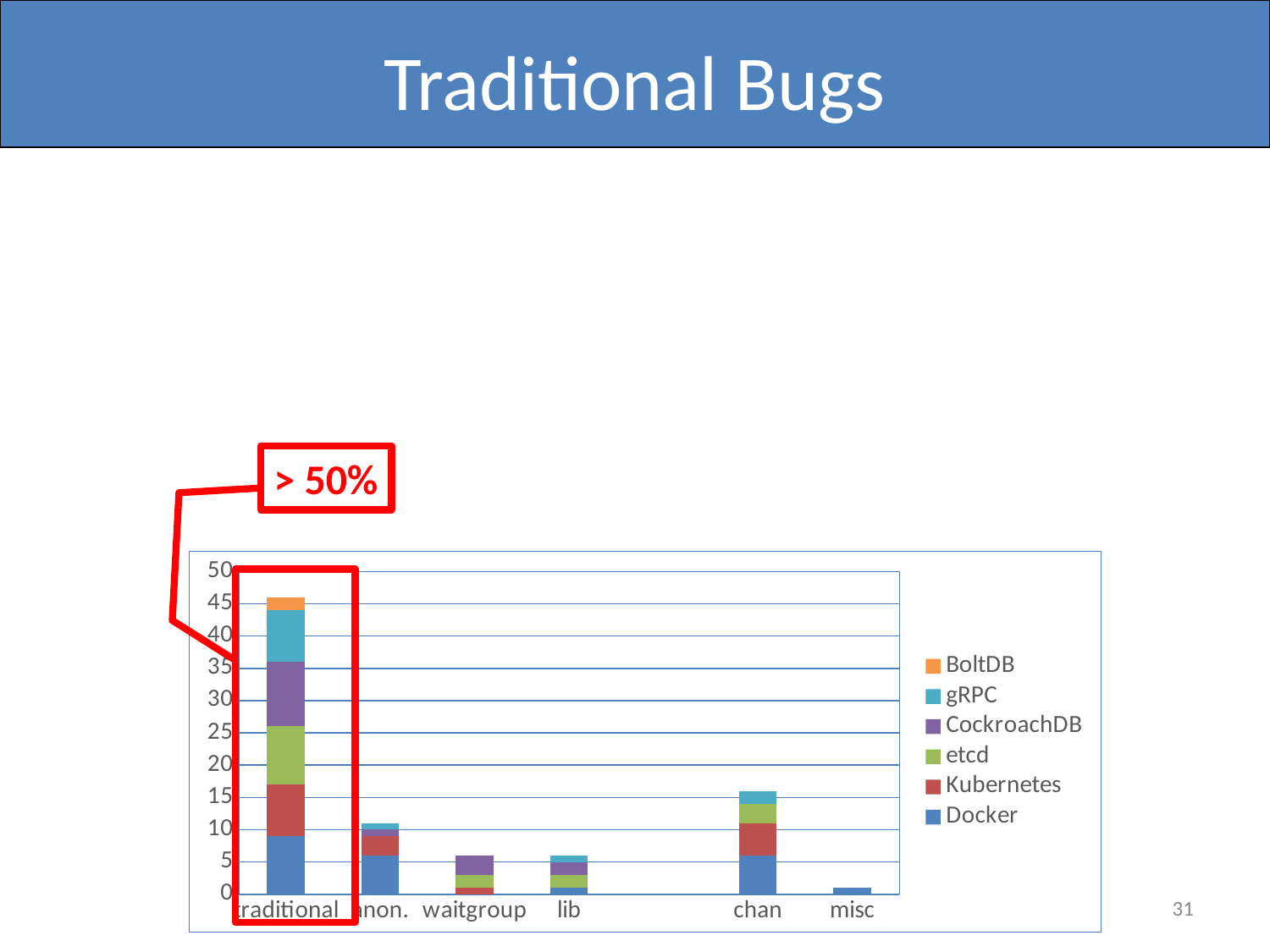
What kind of chart is shown on the slide? bar chart Which bar is taller, traditional or chan? traditional Is the total for the chan bar greater or less than 20? less Is the total for the waitgroup bar greater or less than 10? less How many series does the legend list? 6 What text is in the red callout box pointing at the traditional bar? > 50% Which category has the shortest stacked bar? misc Which bar is taller, chan or lib? chan Which category has the tallest stacked bar? traditional Is the total for the traditional bar greater or less than 40? greater Which series is listed last in the legend? Docker